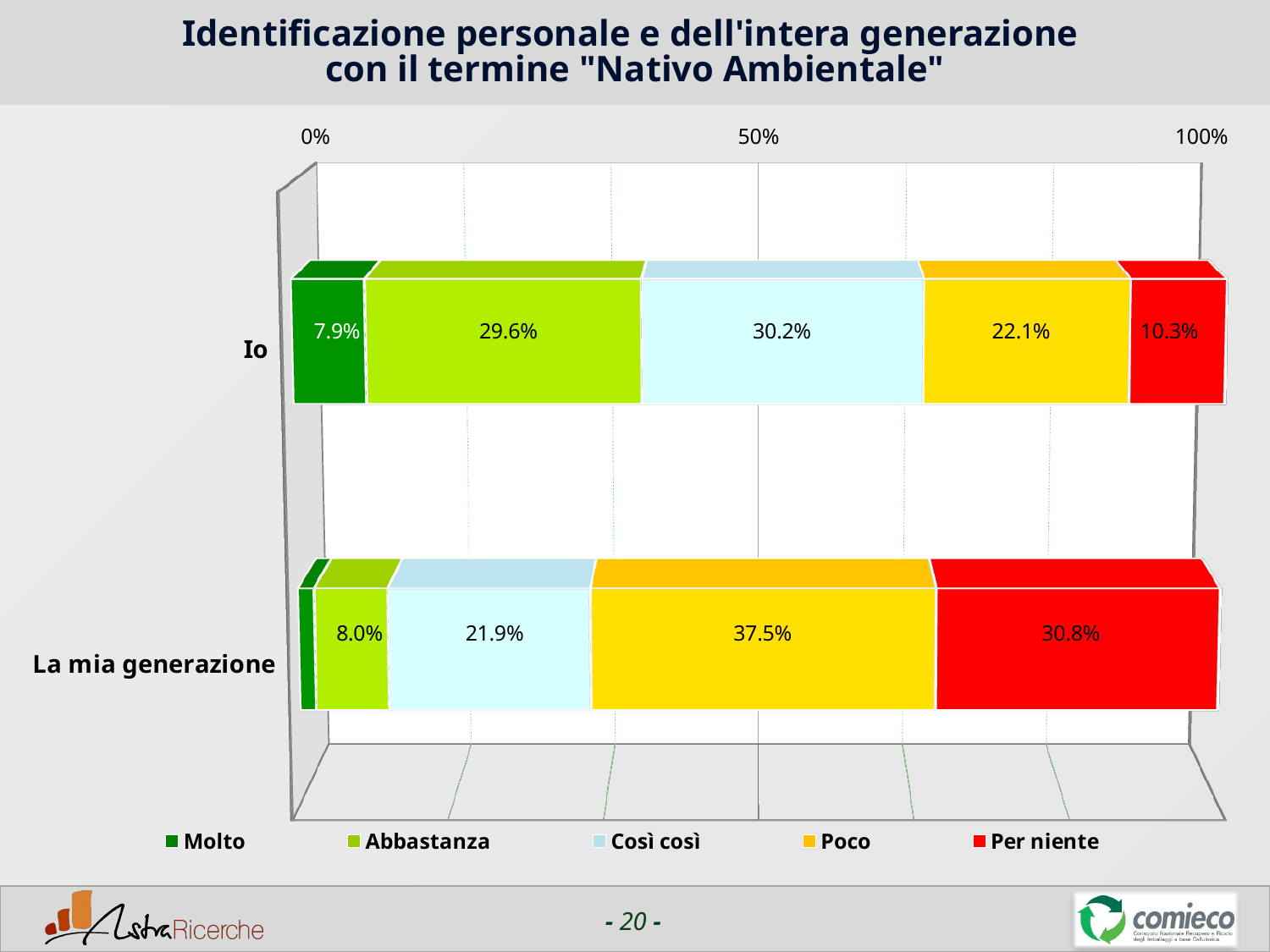
What kind of chart is shown on the slide? stacked bar chart How many categories are plotted on the chart? 2 How many series does the legend list? 5 Which is larger: "Abbastanza" for "Io" or "Abbastanza" for "La mia generazione"? Io Which colour represents "Per niente" in the legend? red What is the difference between the "Per niente" values for "La mia generazione" and "Io"? 20.5% What is the value of "Poco" for "La mia generazione"? 37.5% What is the value of "Per niente" for "Io"? 10.3% What is the value of "Così così" for "Io"? 30.2% Which response has the largest share in the "La mia generazione" bar? Poco What is the value of "Abbastanza" for "La mia generazione"? 8.0% Which response has the smallest share in the "Io" bar? Molto